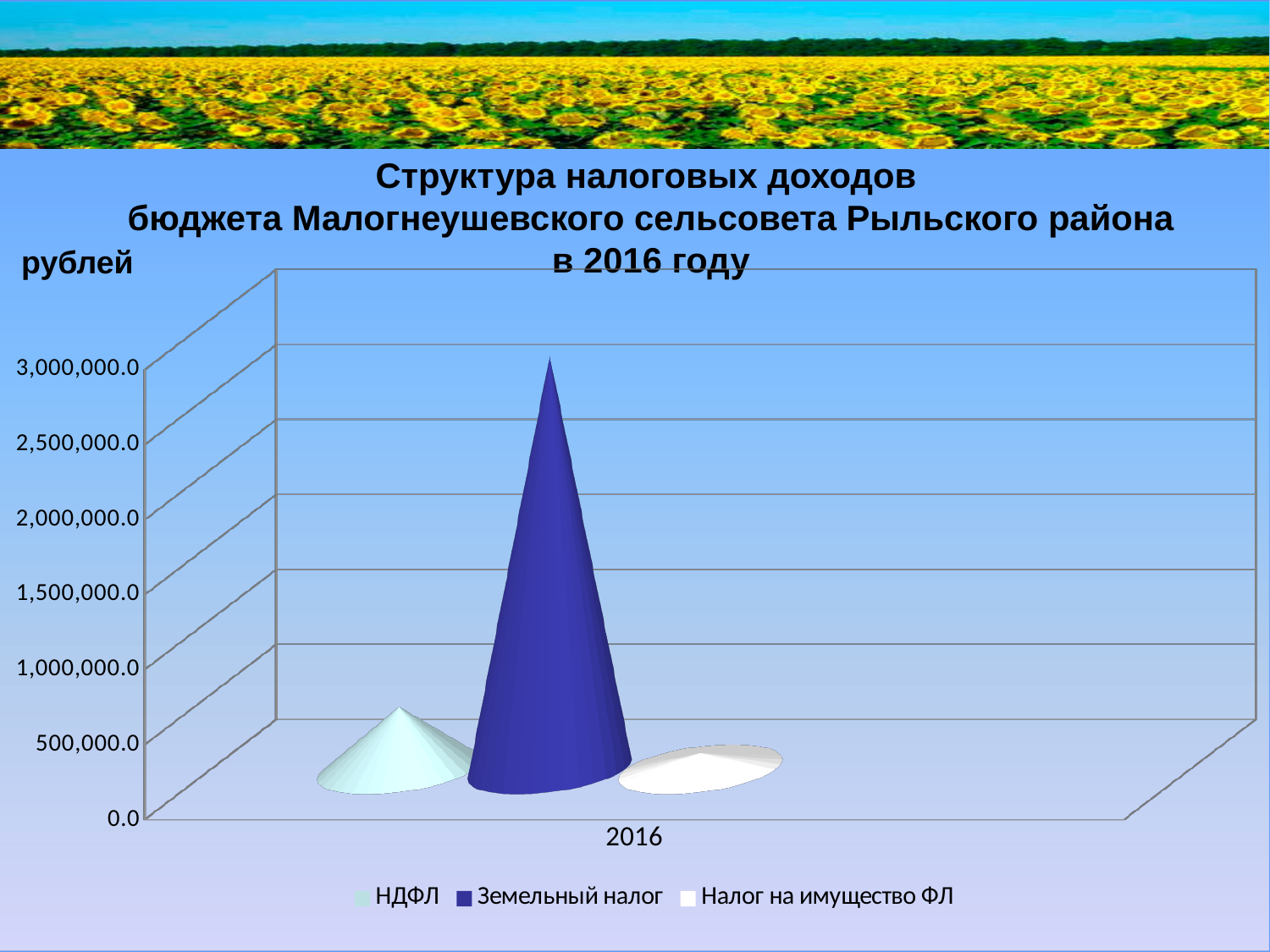
Which is larger in 2016, НДФЛ or Земельный налог? Земельный налог How many categories are shown on the x axis? 1 Is the value for Налог на имущество ФЛ greater or less than 500,000.0? less Is the value for Земельный налог greater or less than 2,000,000.0? greater What unit label is shown at the top of the vertical axis? рублей Which series has the highest value in 2016? Земельный налог What kind of chart is shown on the slide? bar chart How many series does the legend list? 3 What year is shown on the x axis of the chart? 2016 Which is larger in 2016, НДФЛ or Налог на имущество ФЛ? НДФЛ Is the value for НДФЛ greater or less than 1,000,000.0? less Which series has the lowest value in 2016? Налог на имущество ФЛ